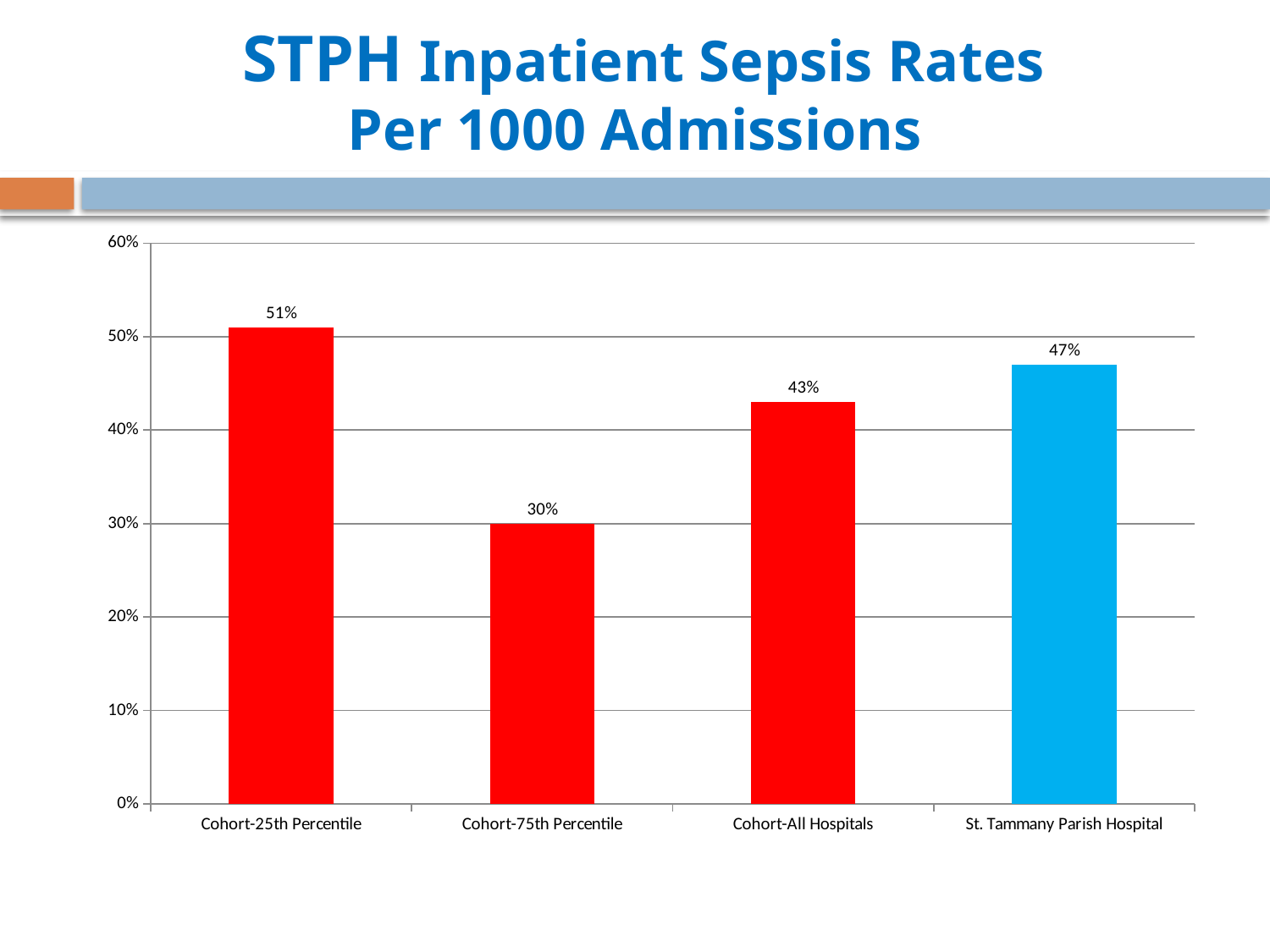
Which category has the highest value? Cohort-25th Percentile What kind of chart is shown on the slide? Bar chart How many categories are shown on the x axis? 4 Which bar is coloured differently from the others? St. Tammany Parish Hospital What is the difference between the values for St. Tammany Parish Hospital and Cohort-All Hospitals? 4% What is the value for Cohort-All Hospitals? 43% Which is larger, the value for St. Tammany Parish Hospital or the value for Cohort-All Hospitals? St. Tammany Parish Hospital What is the value for Cohort-75th Percentile? 30% Which category has the lowest value? Cohort-75th Percentile What is the value for St. Tammany Parish Hospital? 47% What is the value for Cohort-25th Percentile? 51% What is the difference between the values for Cohort-25th Percentile and Cohort-75th Percentile? 21%